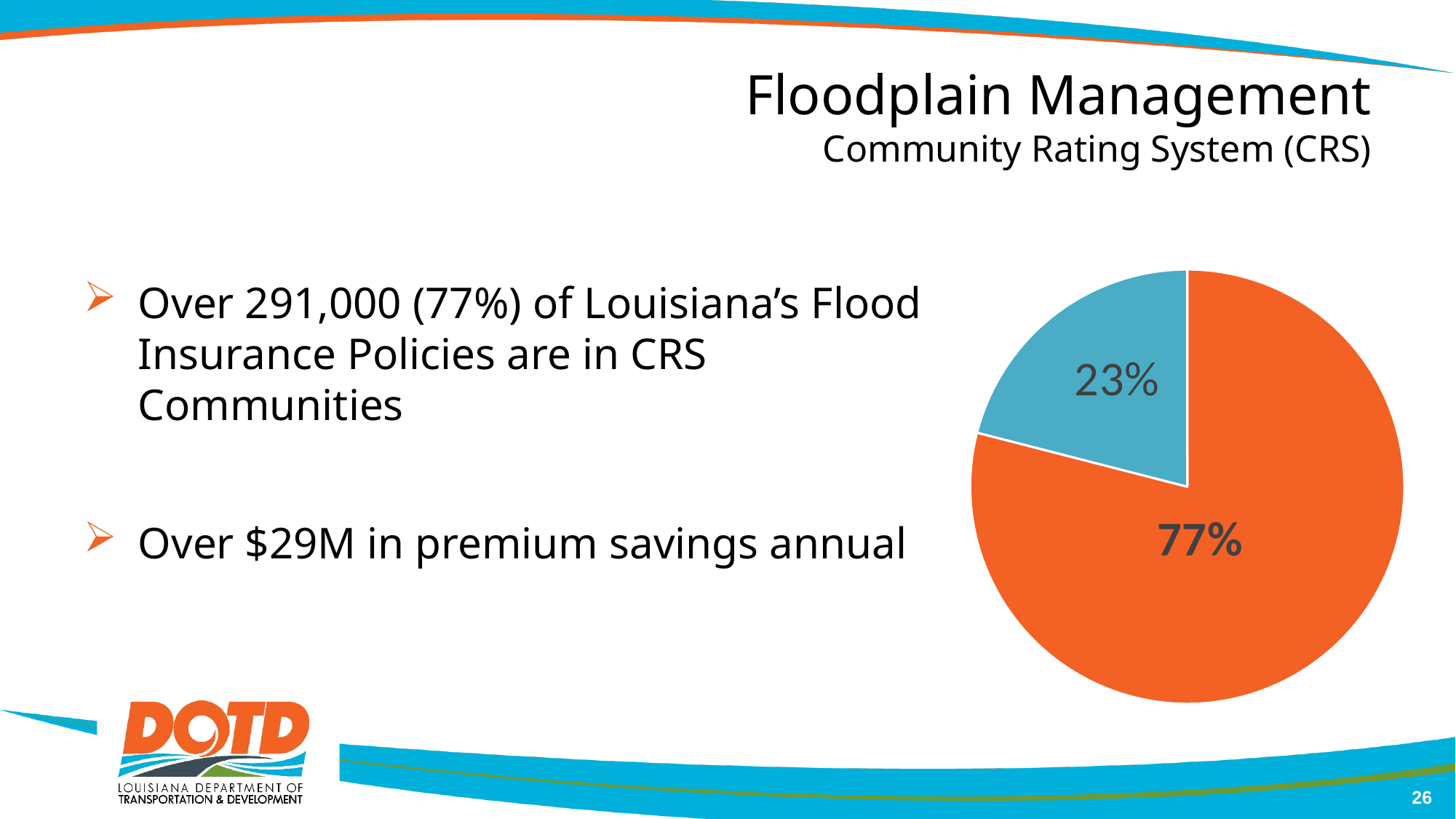
What percentage is shown on the blue slice of the pie chart? 23% Is the orange slice or the blue slice larger? the orange slice Is the value of the blue slice greater or less than 50%? less How many slices does the pie chart have? 2 Which slice of the pie chart is the largest? the orange slice (77%) What kind of chart is shown on the slide? pie chart What percentage is shown on the orange slice of the pie chart? 77% What colour is the slice labelled 77%? orange What share of the pie does the blue slice represent? 23% Does the pie chart include a legend? No What is the difference in percentage points between the orange slice and the blue slice? 54 Which slice of the pie chart is the smallest? the blue slice (23%)